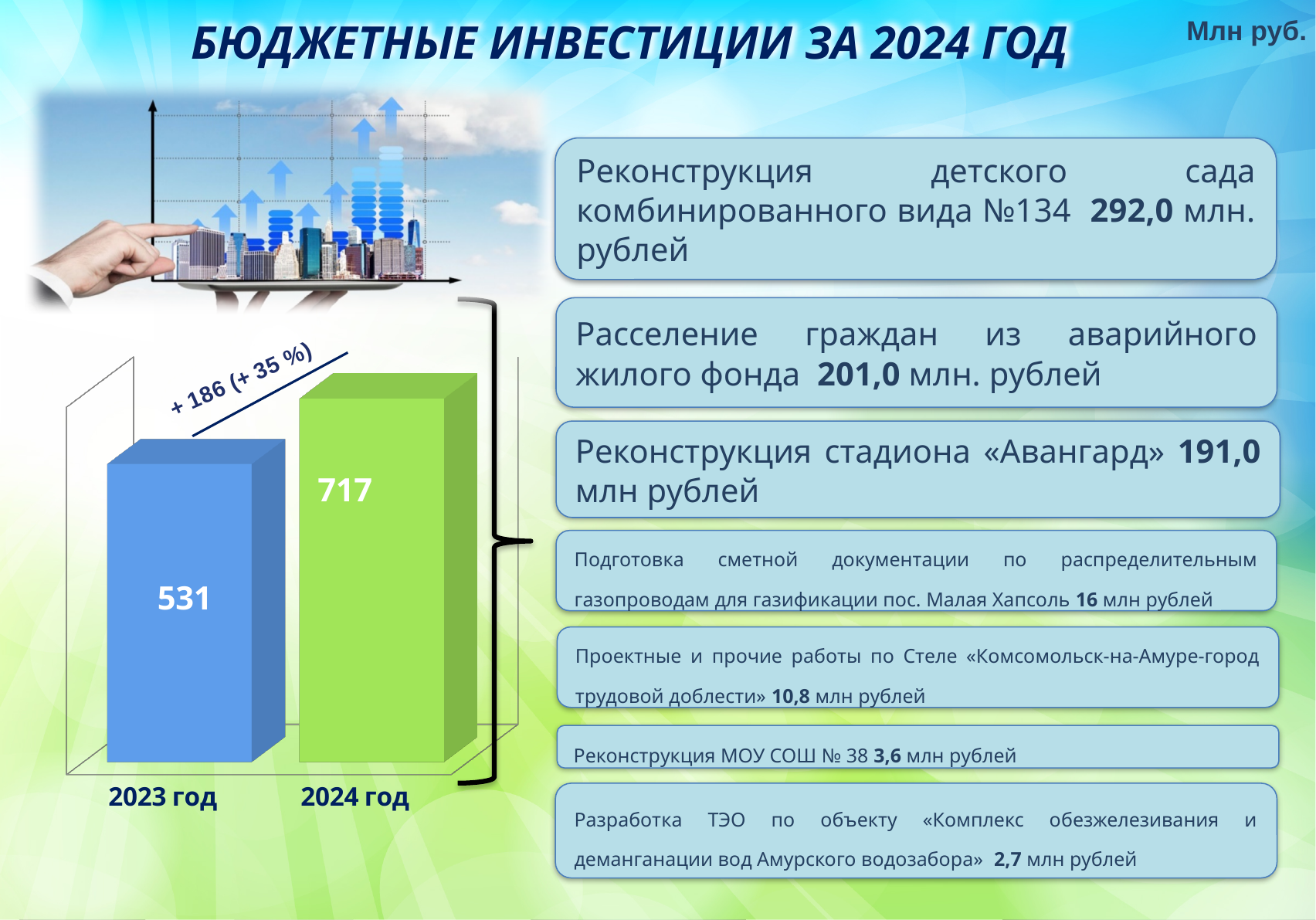
What is the value for 2024 год? 717 What colour is the bar for 2024 год? green Which year has the higher value? 2024 год Is the value for 2024 год larger or smaller than the value for 2023 год? larger What is the value for 2023 год? 531 Which year has the lower value? 2023 год What kind of chart is shown on the slide? bar chart What percentage increase is annotated above the bars? + 35 % What is the difference between the values for 2024 год and 2023 год? 186 Do the values rise or fall from 2023 год to 2024 год? rise How many bars are shown in the chart? 2